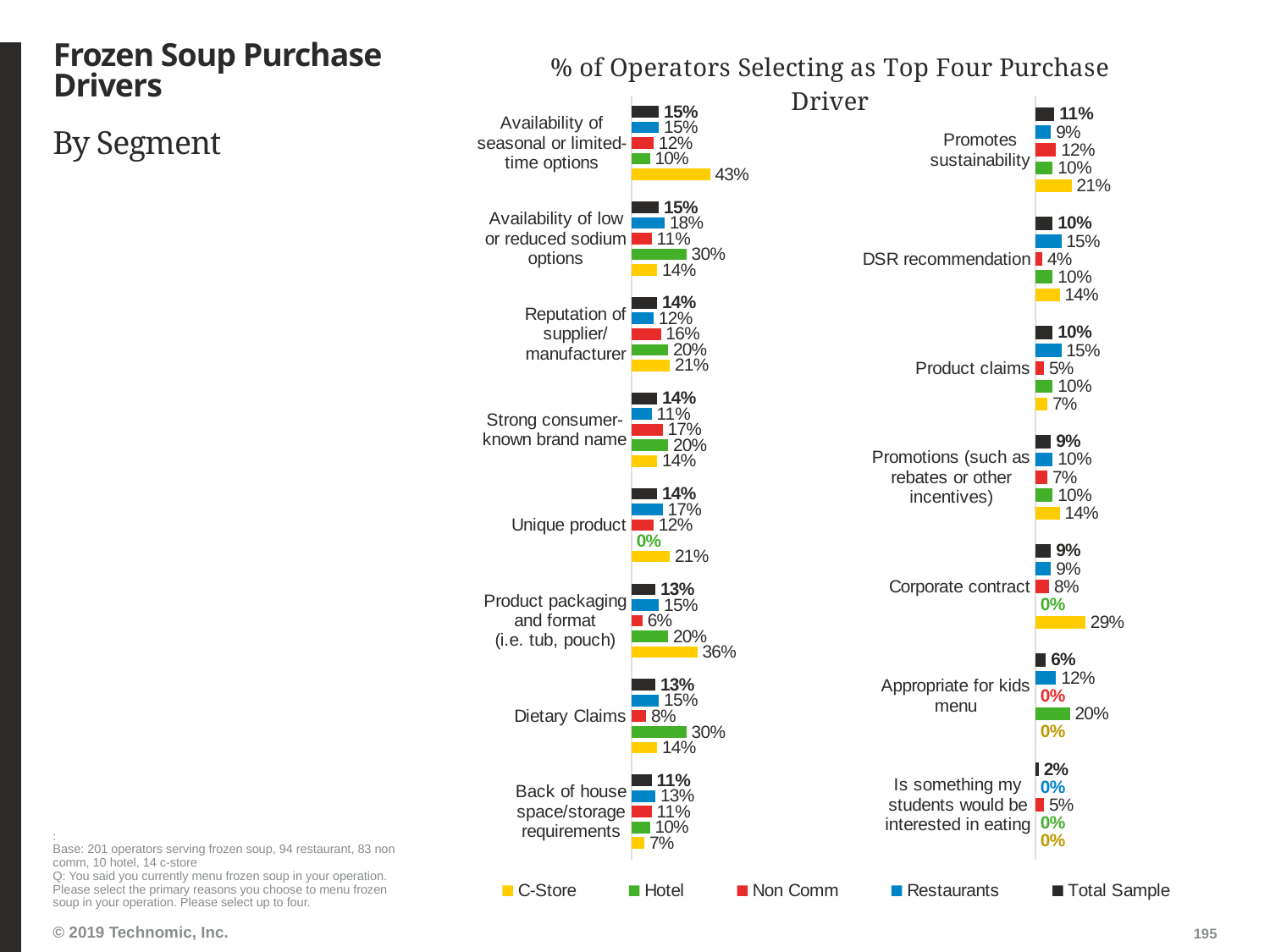
What is the difference between the C-Store and Hotel values for 'Product packaging and format (i.e. tub, pouch)'? 16% What percentage of C-Store operators selected 'Availability of seasonal or limited-time options' as a top four purchase driver? 43% What is the Total Sample value for 'Promotes sustainability'? 11% How many segments does the legend list? 5 What percentage of Hotel operators selected 'Dietary Claims'? 30% Which colour represents the Hotel segment in the chart? Green Which purchase driver has the highest Total Sample percentage? Availability of seasonal or limited-time options (tied with Availability of low or reduced sodium options) Which purchase driver has the lowest Total Sample percentage? Is something my students would be interested in eating How many purchase drivers (categories) are shown in the chart? 15 What type of chart is shown on the slide? Bar chart What is the Non Comm value for 'DSR recommendation'? 4% For 'Corporate contract', which segment has a higher value: C-Store or Restaurants? C-Store